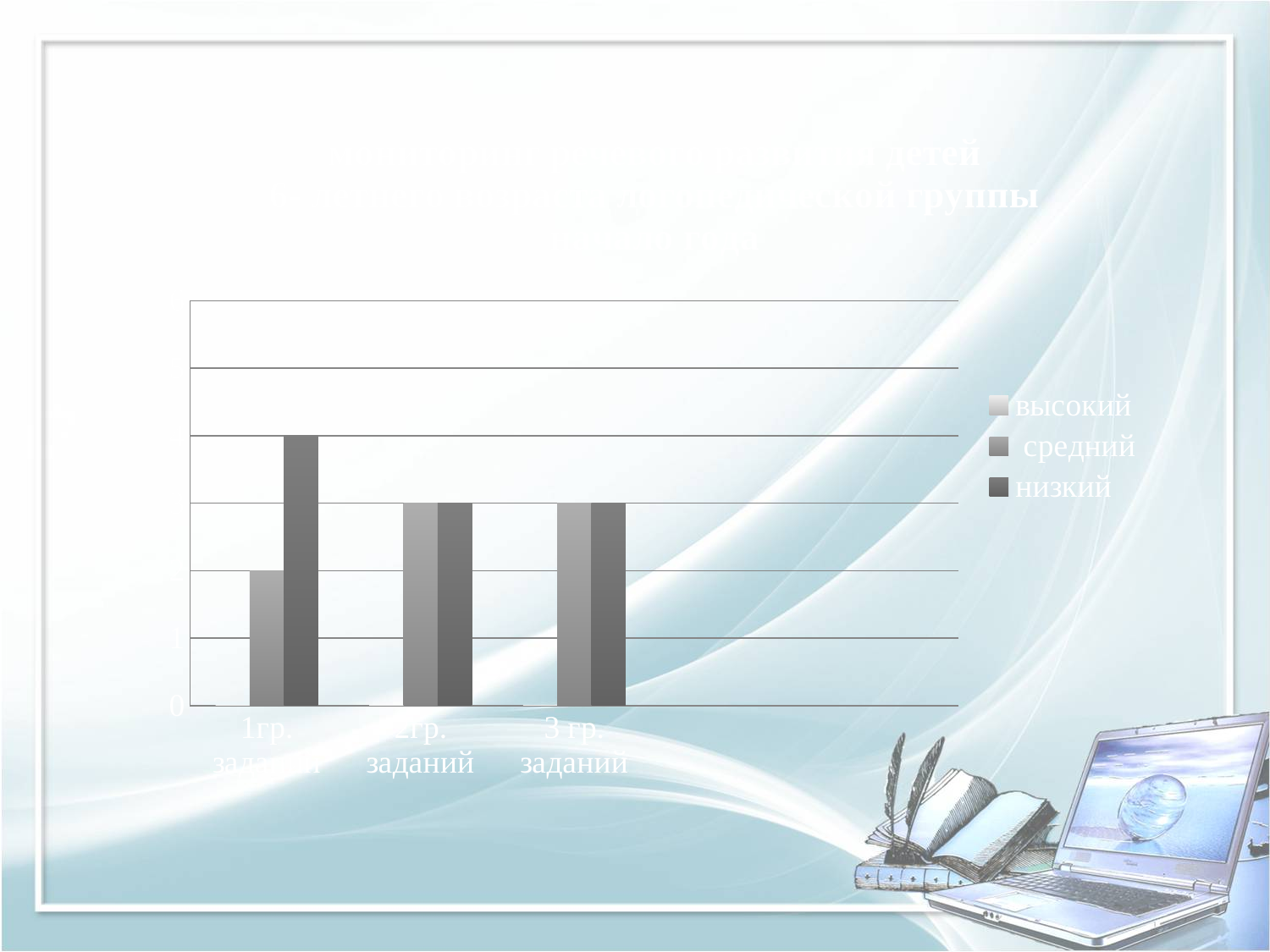
What kind of chart is shown on the slide? bar chart Does the средний series rise or fall from 1гр. заданий to 2гр. заданий? rise Which category has the lowest value for the средний series? 1гр. заданий How many categories are shown on the x axis of the chart? 3 Is the value of средний for 2гр. заданий greater or less than 1? greater Is the value of низкий for 1гр. заданий greater or less than 1? greater What are the three series named in the chart's legend? высокий, средний, низкий Which category has the highest value for the низкий series? 1гр. заданий How many series does the chart's legend list? 3 For 1гр. заданий, which is larger: средний or низкий? низкий What is the label of the first category on the x axis? 1гр. заданий Does the низкий series rise or fall from 1гр. заданий to 2гр. заданий? fall